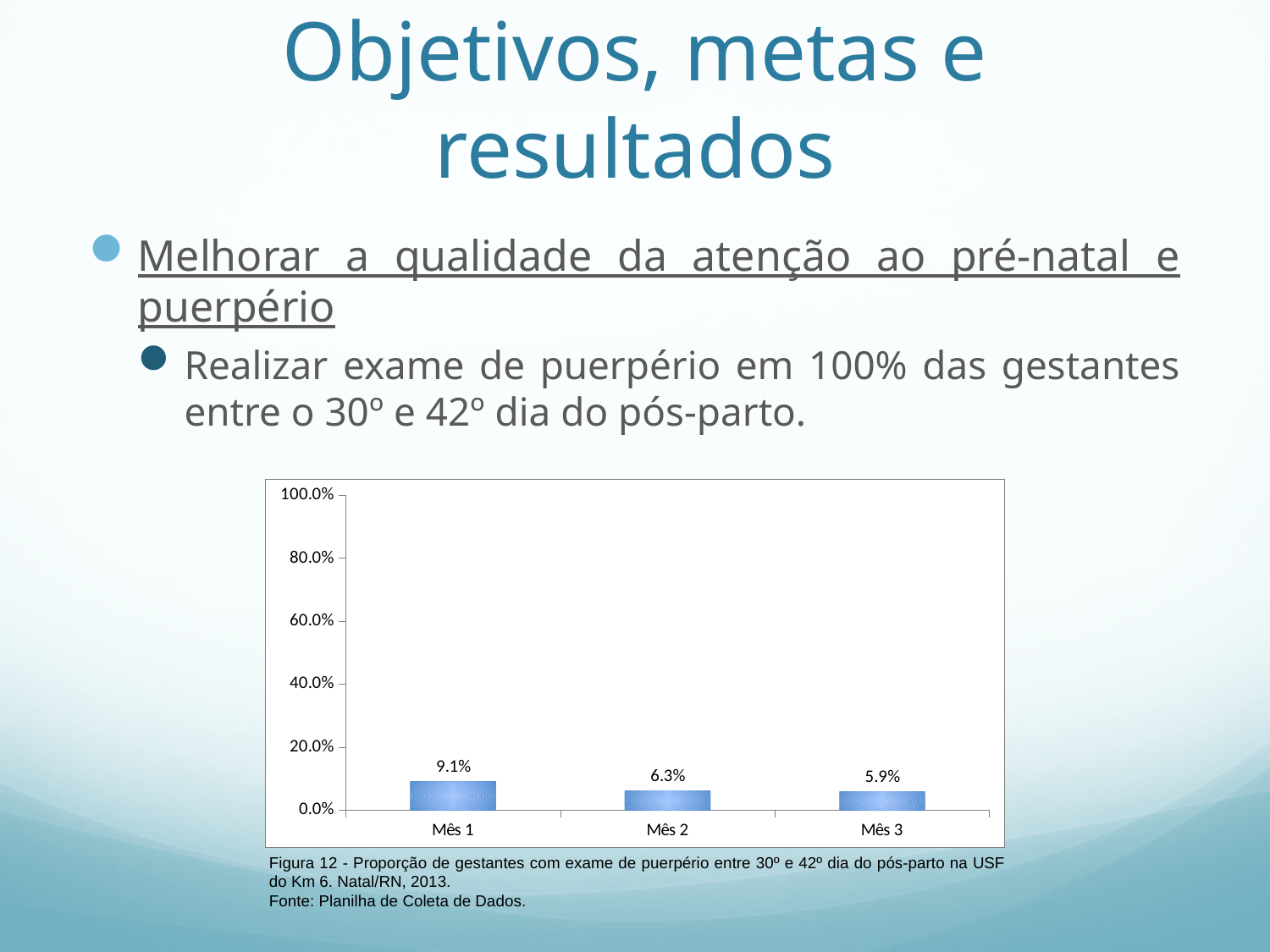
How many months are shown on the x axis? 3 What is the difference between the values for Mês 1 and Mês 3? 3.2% Is the value for Mês 1 greater or less than 20.0%? less Which month has the highest value? Mês 1 What is the difference between the values for Mês 1 and Mês 2? 2.8% What is the value for Mês 1? 9.1% What kind of chart is shown on the slide? bar chart What is the value for Mês 2? 6.3% What is the value for Mês 3? 5.9% Do the values rise or fall from Mês 1 to Mês 3? fall Which is larger, the value for Mês 1 or the value for Mês 2? Mês 1 Which month has the lowest value? Mês 3